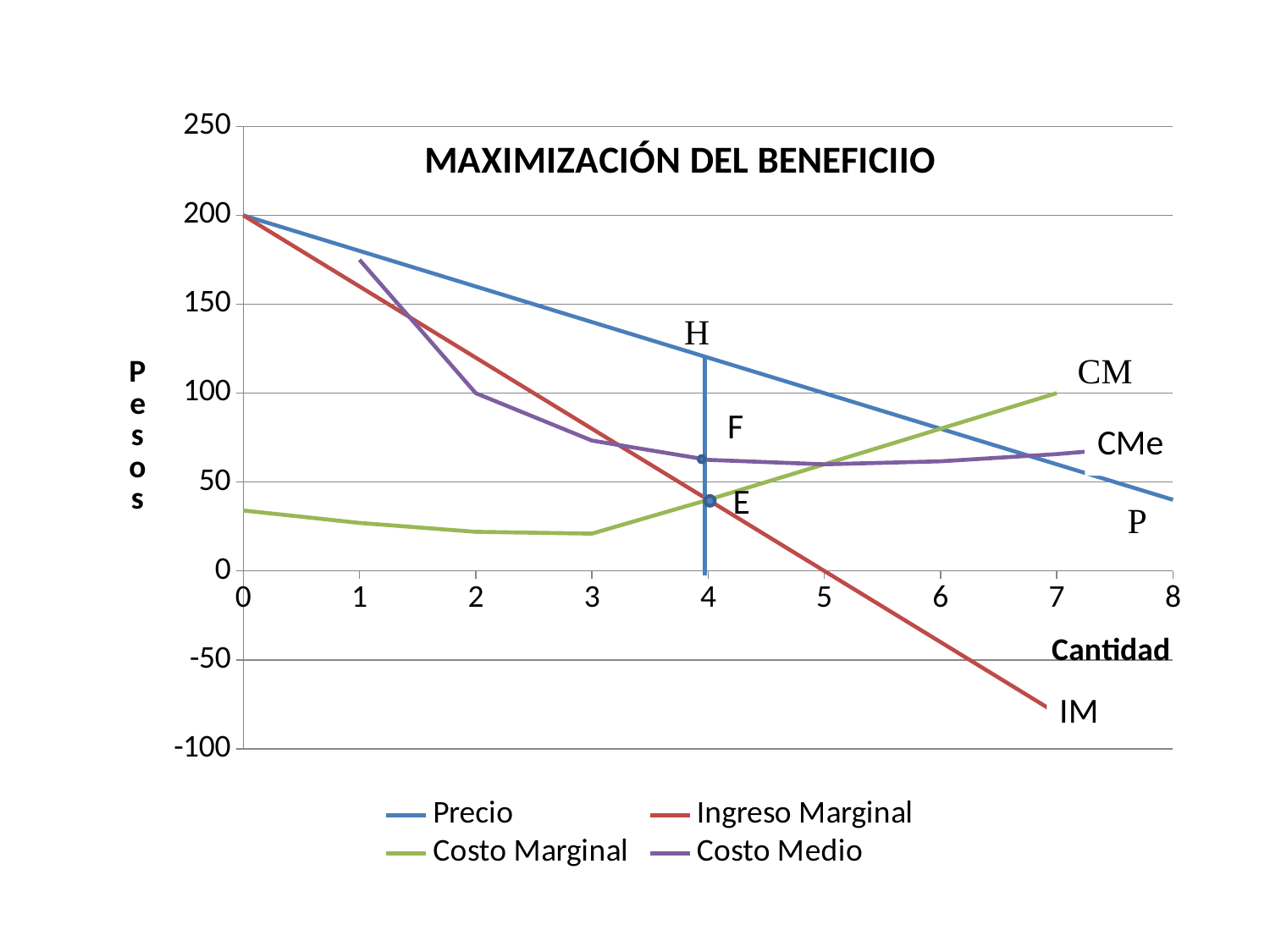
Is the value of Costo Marginal at Cantidad 3 greater or less than 50? less Is the value of Precio at Cantidad 4 greater or less than 100? greater At Cantidad 7, which is larger, Costo Marginal or Costo Medio? Costo Marginal What is the label of the horizontal axis? Cantidad What is the value of Precio at Cantidad 0? 200 What is the title of the chart? MAXIMIZACIÓN DEL BENEFICIIO Is the value of Ingreso Marginal at Cantidad 7 greater or less than -50? less How many series does the legend list? 4 What is the value of Costo Medio at Cantidad 2? 100 At what Cantidad does Ingreso Marginal cross 0? 5 What kind of chart is shown on the slide? line chart What is the value of Costo Marginal at Cantidad 7? 100